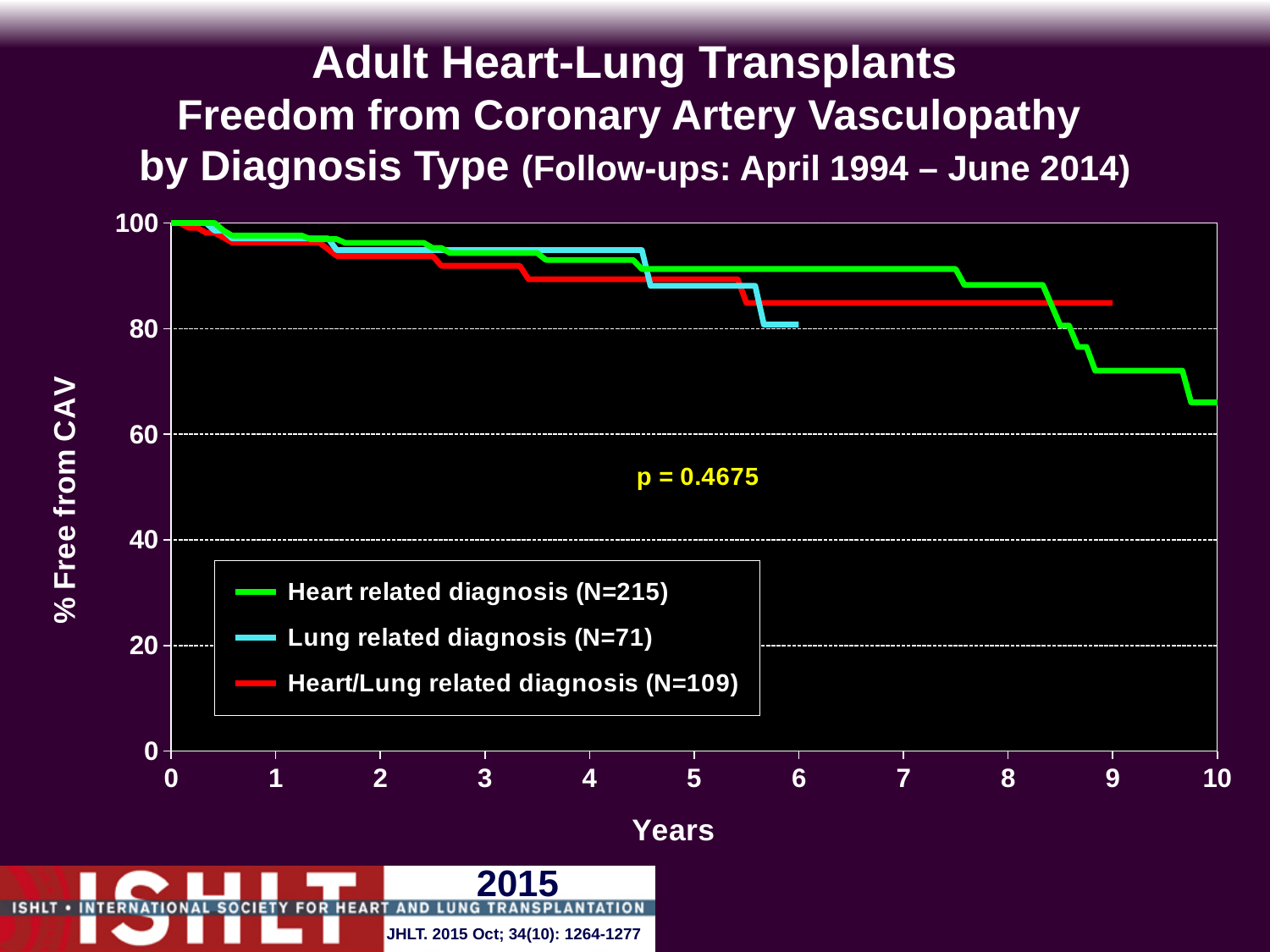
What is the sample size (N) shown in the legend for the Lung related diagnosis series? 71 What kind of chart is shown on the slide? Line chart What is the label of the y axis? % Free from CAV Do the values for the Heart related diagnosis series rise or fall as years increase? Fall What p-value is printed on the chart? p = 0.4675 Is the value for Heart related diagnosis at 10 years greater or less than 60? greater Is the value for Heart related diagnosis at 7 years greater or less than 80? greater How many series does the legend list? 3 Is the value for Lung related diagnosis at 4 years greater or less than 80? greater Which series has the lowest value at the end of its curve? Heart related diagnosis